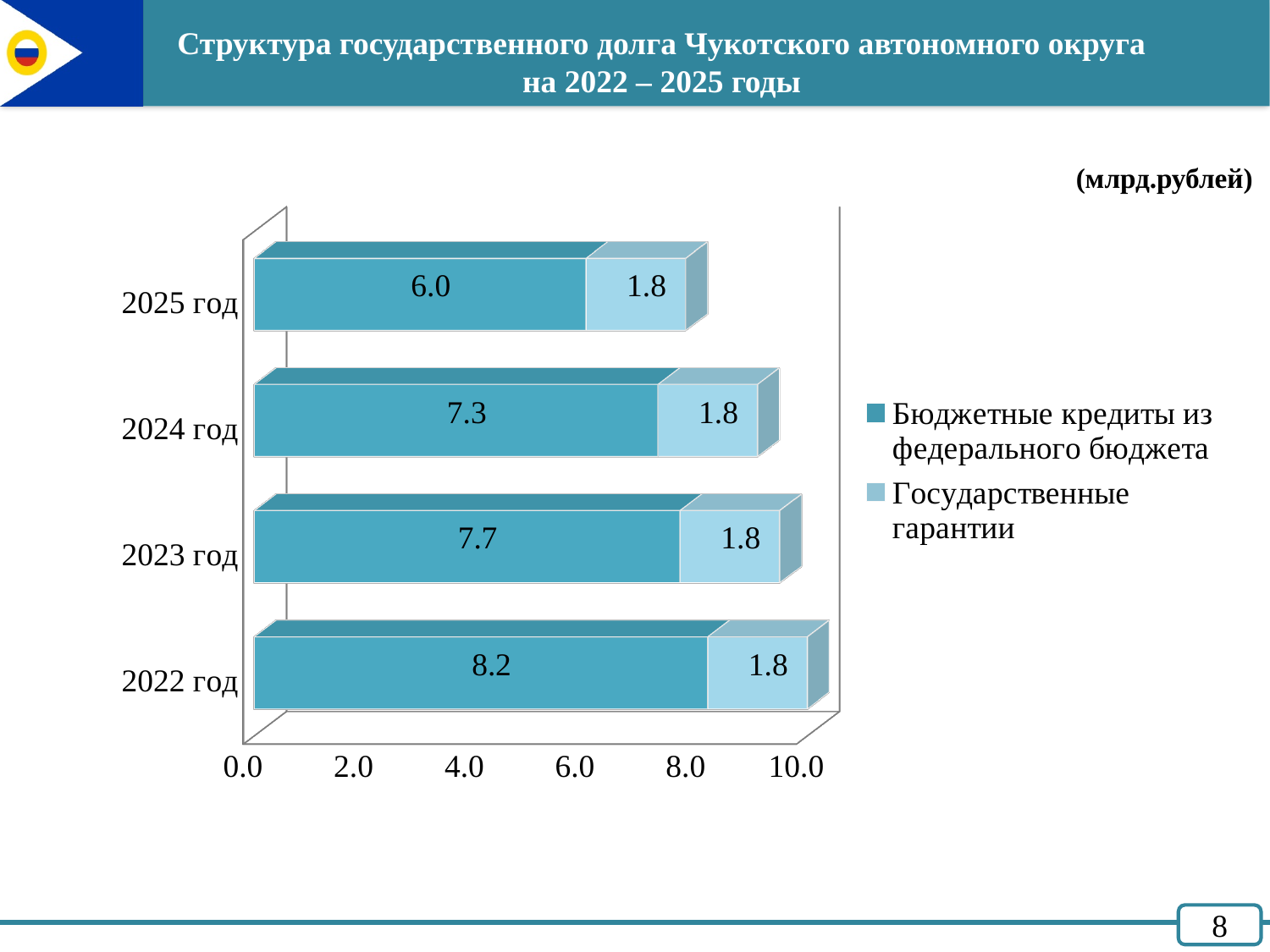
What is the difference between the 'Бюджетные кредиты из федерального бюджета' values for 2022 год and 2025 год? 2.2 How many years are shown on the chart? 4 How many series does the legend list? 2 Which year has the highest value for 'Бюджетные кредиты из федерального бюджета'? 2022 год What is the value of 'Бюджетные кредиты из федерального бюджета' for 2022 год? 8.2 Which is larger: 'Бюджетные кредиты из федерального бюджета' for 2023 год or for 2024 год? 2023 год Which year has the lowest value for 'Бюджетные кредиты из федерального бюджета'? 2025 год What is the value of 'Бюджетные кредиты из федерального бюджета' for 2025 год? 6.0 What is the total of the stacked bar for 2022 год? 10.0 What is the value of 'Государственные гарантии' for 2024 год? 1.8 What is the total of the stacked bar for 2023 год? 9.5 What kind of chart is shown on the slide? Stacked bar chart